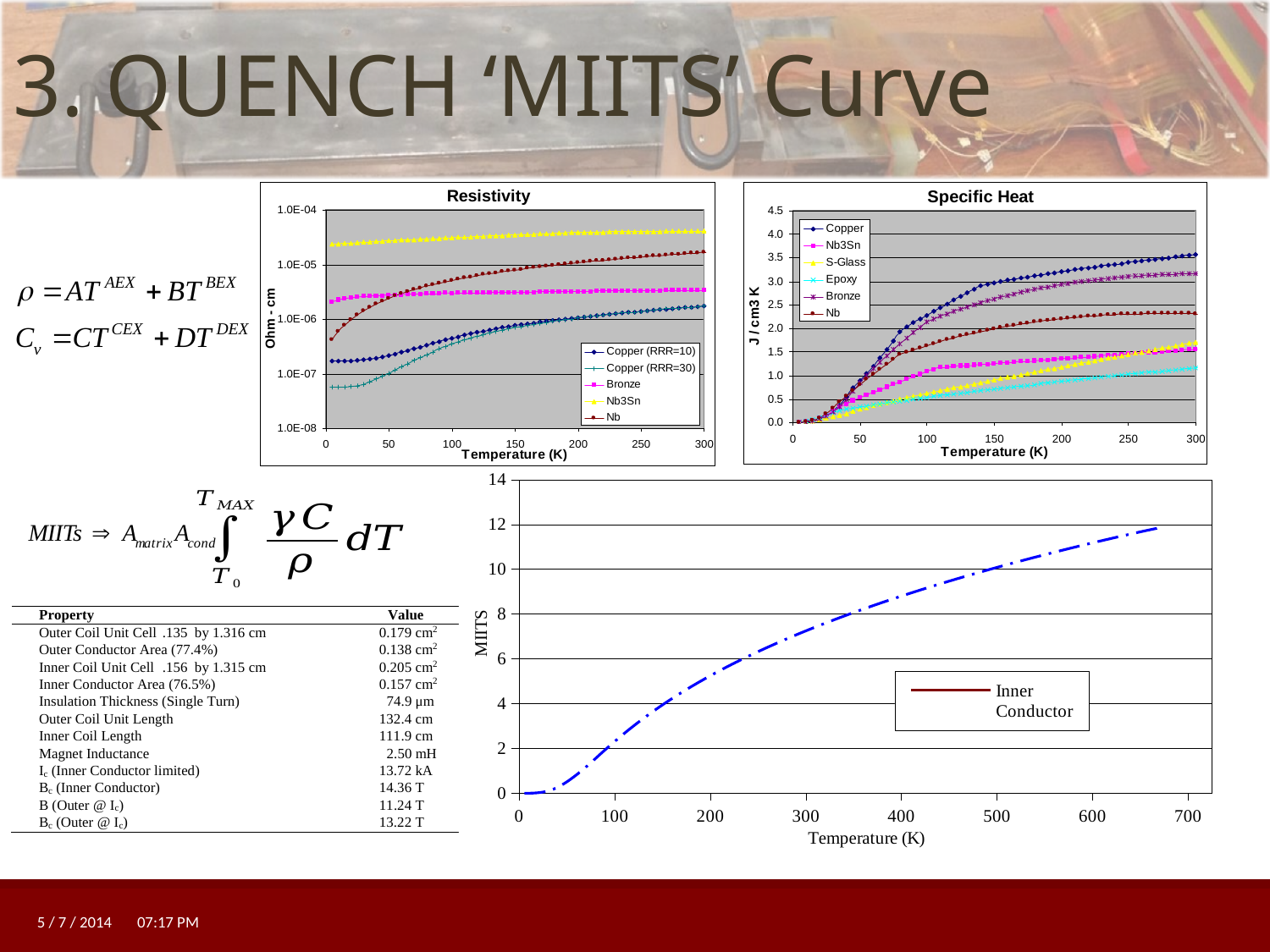
In the Specific Heat chart, which material has the highest specific heat at 300 K? Copper In the MIITS chart at the bottom, does the MIITS value rise or fall as temperature increases? rise What kind of chart is the Resistivity chart? line chart What is the y-axis label of the Resistivity chart? Ohm - cm In the Specific Heat chart, is the value for Copper at 300 K greater or less than 3.0? greater In the Resistivity chart, which series has the lowest resistivity at low temperatures (below 50 K)? Copper (RRR=30) How many series does the legend of the Specific Heat chart list? 6 How many series does the legend of the Resistivity chart list? 5 In the MIITS chart at the bottom, is the value at 300 K greater or less than 6? greater In the Specific Heat chart, which material has the lowest specific heat at 300 K? Epoxy In the Specific Heat chart, is the value for Nb at 300 K greater or less than 2.0? greater In the Resistivity chart, which material has the highest resistivity across the temperature range? Nb3Sn